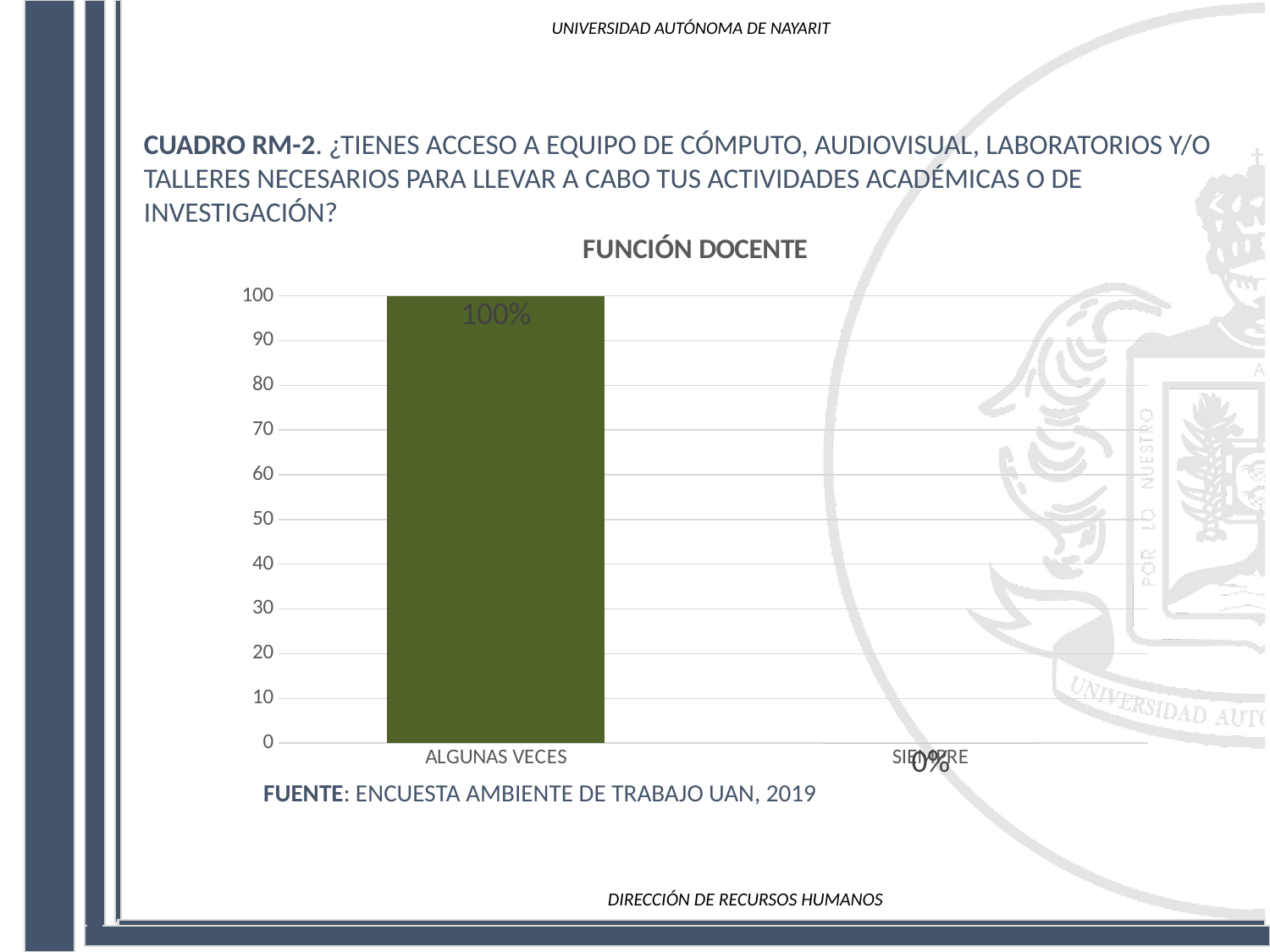
What kind of chart is shown? bar chart What is the highest value shown on the vertical axis? 100 Is the value for ALGUNAS VECES greater or less than 50? greater Which category has the highest value? ALGUNAS VECES What is the value for ALGUNAS VECES? 100% How many categories are shown on the x axis? 2 What is the value for SIEMPRE? 0% What is the difference between the values for ALGUNAS VECES and SIEMPRE? 100% What is the title of the chart? FUNCIÓN DOCENTE Which category has the lowest value? SIEMPRE Which is larger, the value for ALGUNAS VECES or the value for SIEMPRE? ALGUNAS VECES